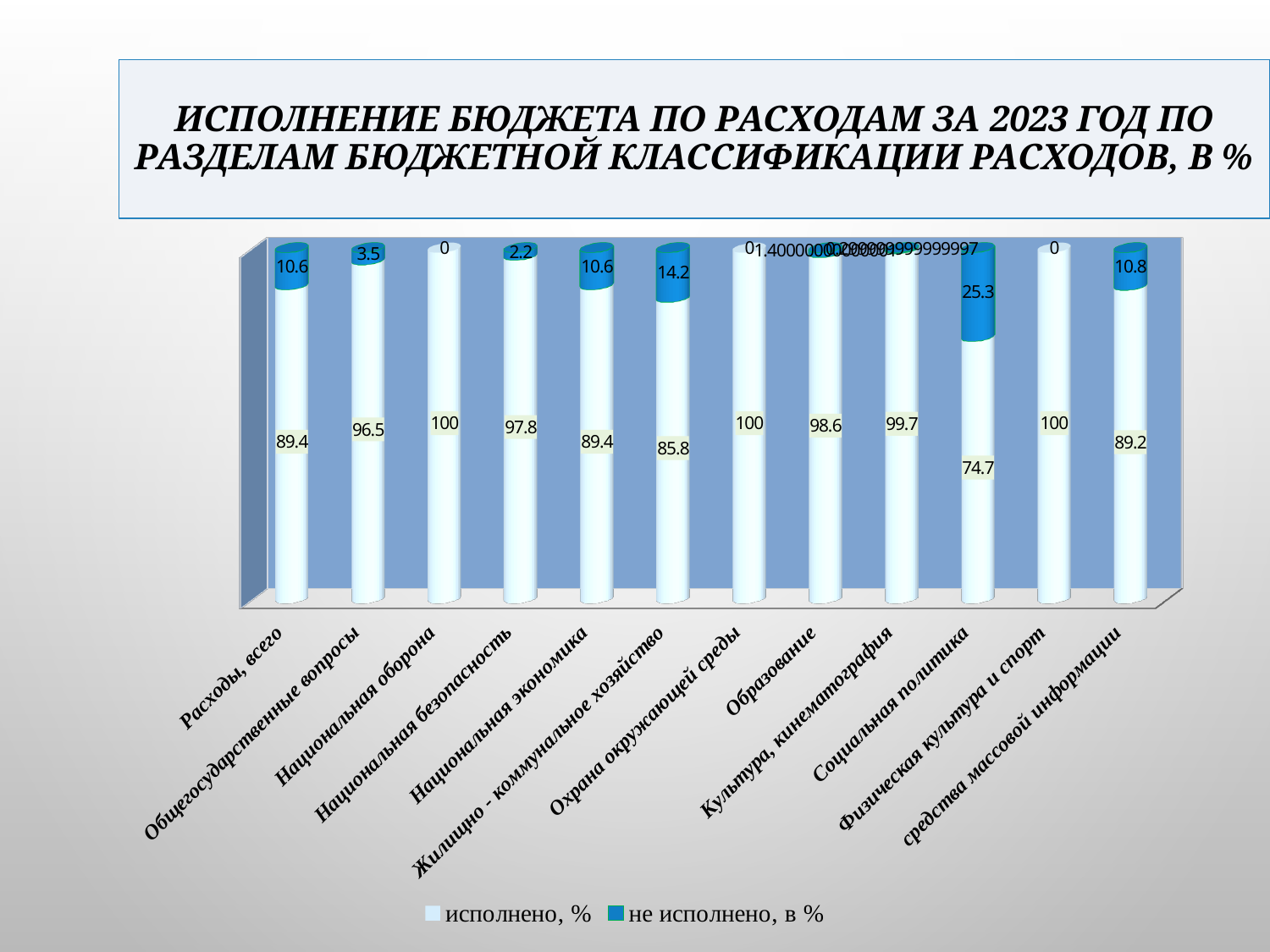
Which category has the highest value of "не исполнено, в %"? Социальная политика What is the total of the stacked bar for "Национальная экономика"? 100 Which category has the lowest value of "исполнено, %"? Социальная политика What is the value of "исполнено, %" for "Общегосударственные вопросы"? 96.5 What is the value of "исполнено, %" for "Социальная политика"? 74.7 Which is larger: the "исполнено, %" value for "Расходы, всего" or for "средства массовой информации"? Расходы, всего What is the value of "не исполнено, в %" for "Жилищно - коммунальное хозяйство"? 14.2 What is the difference between the "исполнено, %" values for "Национальная безопасность" and "Жилищно - коммунальное хозяйство"? 12 What is the value of "не исполнено, в %" for "Национальная безопасность"? 2.2 How many series does the legend list? 2 How many categories are shown on the x axis? 12 What kind of chart is shown on the slide? bar chart